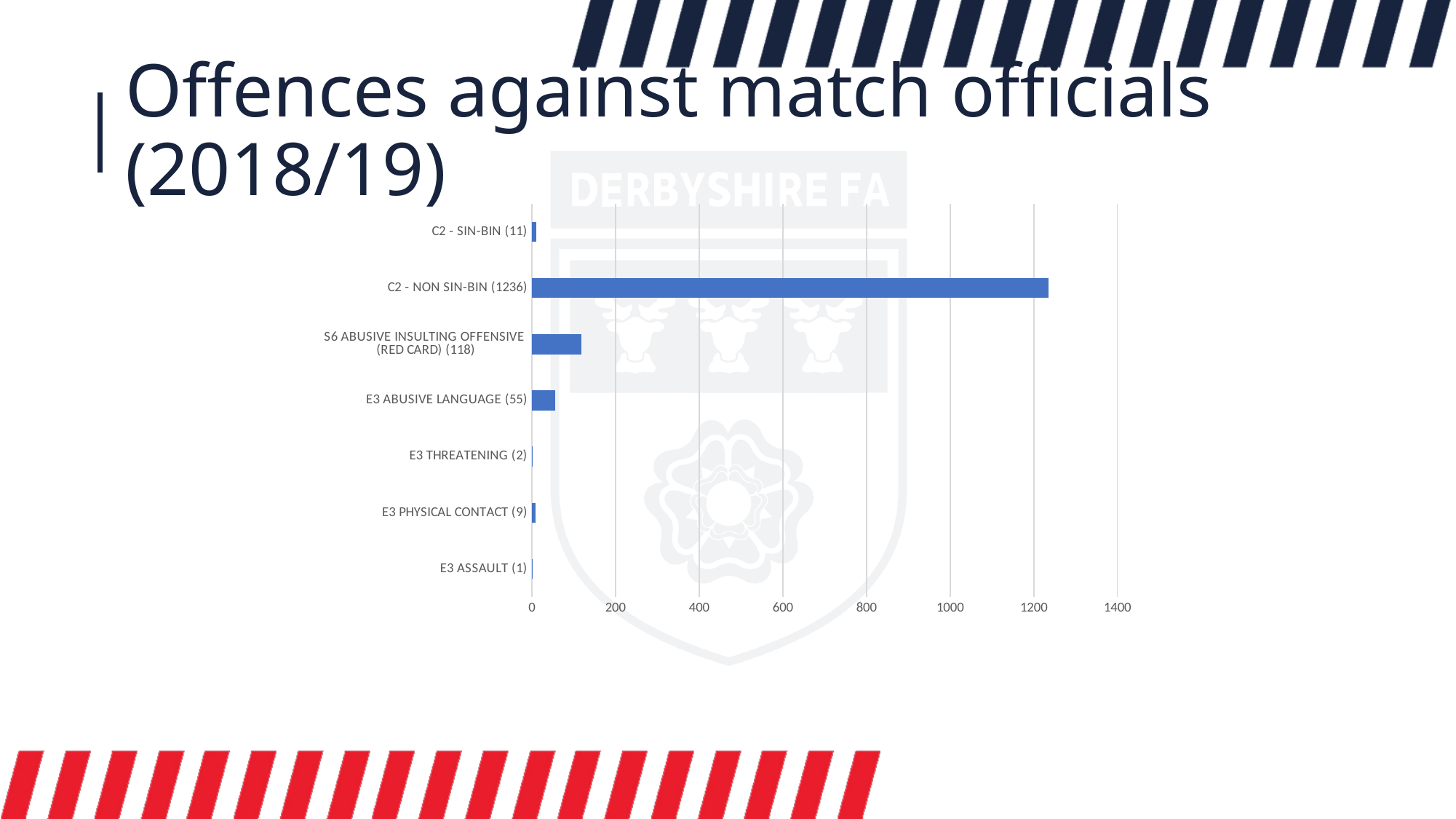
What is the difference between the values for E3 ABUSIVE LANGUAGE and C2 - SIN-BIN? 44 What is the value for C2 - NON SIN-BIN? 1236 What is the value for E3 ABUSIVE LANGUAGE? 55 Which category has the lowest value? E3 ASSAULT Which category has the highest value? C2 - NON SIN-BIN What kind of chart is shown on the slide? Bar chart How many categories are shown in the chart? 7 What is the value for S6 ABUSIVE INSULTING OFFENSIVE (RED CARD)? 118 What is the value for E3 PHYSICAL CONTACT? 9 Is the value for C2 - NON SIN-BIN greater or less than 1200? greater What is the difference between the values for C2 - NON SIN-BIN and S6 ABUSIVE INSULTING OFFENSIVE (RED CARD)? 1118 Which is larger, the value for E3 ABUSIVE LANGUAGE or the value for S6 ABUSIVE INSULTING OFFENSIVE (RED CARD)? S6 ABUSIVE INSULTING OFFENSIVE (RED CARD)